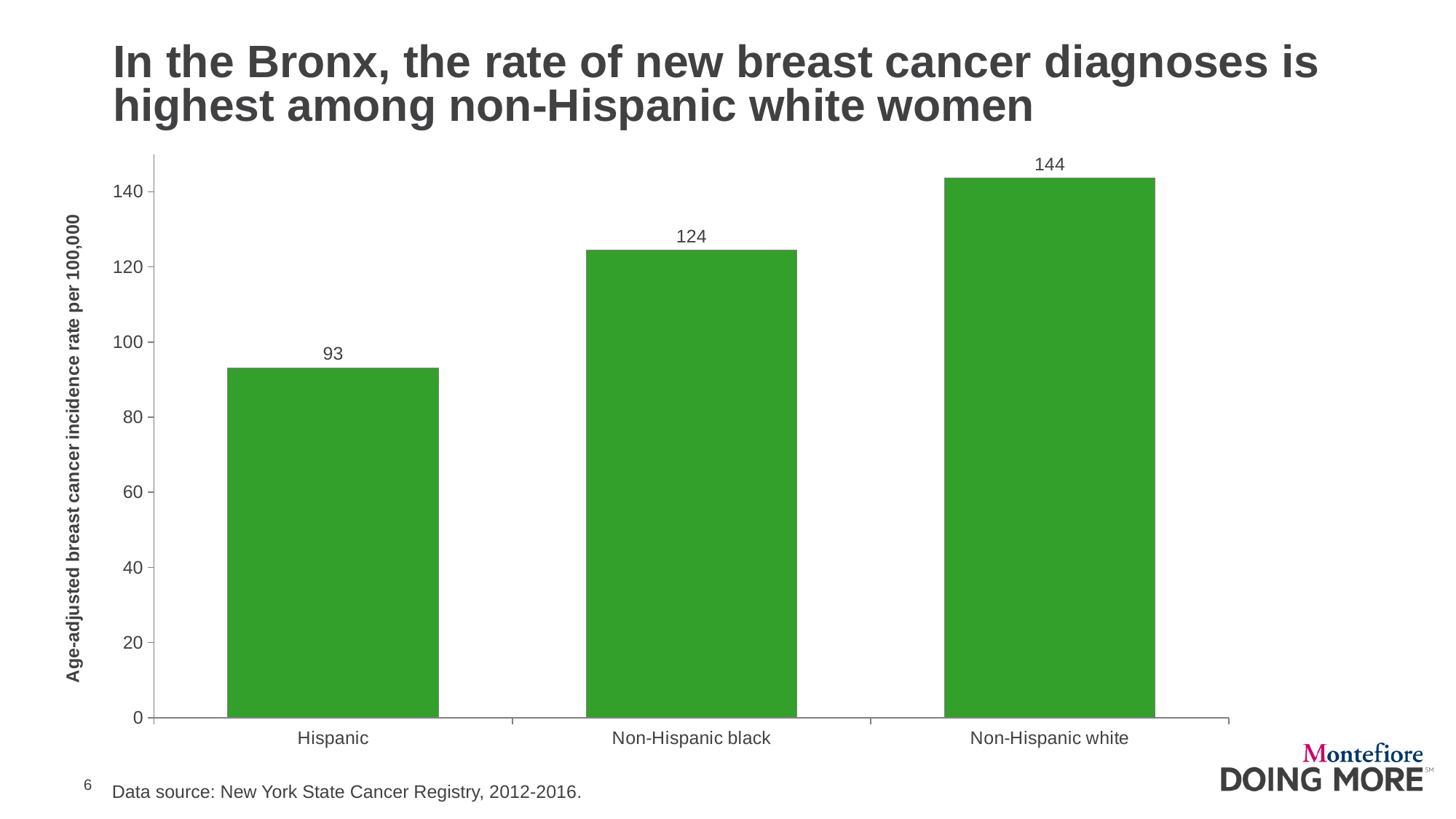
What is the difference between the incidence rates for non-Hispanic white and non-Hispanic black women? 20 What is the label of the vertical axis? Age-adjusted breast cancer incidence rate per 100,000 What is the difference between the incidence rates for non-Hispanic white and Hispanic women? 51 What is the age-adjusted breast cancer incidence rate per 100,000 for Hispanic women? 93 Which group has the lowest breast cancer incidence rate? Hispanic How many groups are shown on the chart? 3 Which group has a higher incidence rate, Hispanic or non-Hispanic black? Non-Hispanic black What kind of chart is shown on the slide? Bar chart What is the age-adjusted breast cancer incidence rate per 100,000 for non-Hispanic white women? 144 Which group has the highest breast cancer incidence rate? Non-Hispanic white Is the value for non-Hispanic black women greater or less than 120? greater What is the age-adjusted breast cancer incidence rate per 100,000 for non-Hispanic black women? 124